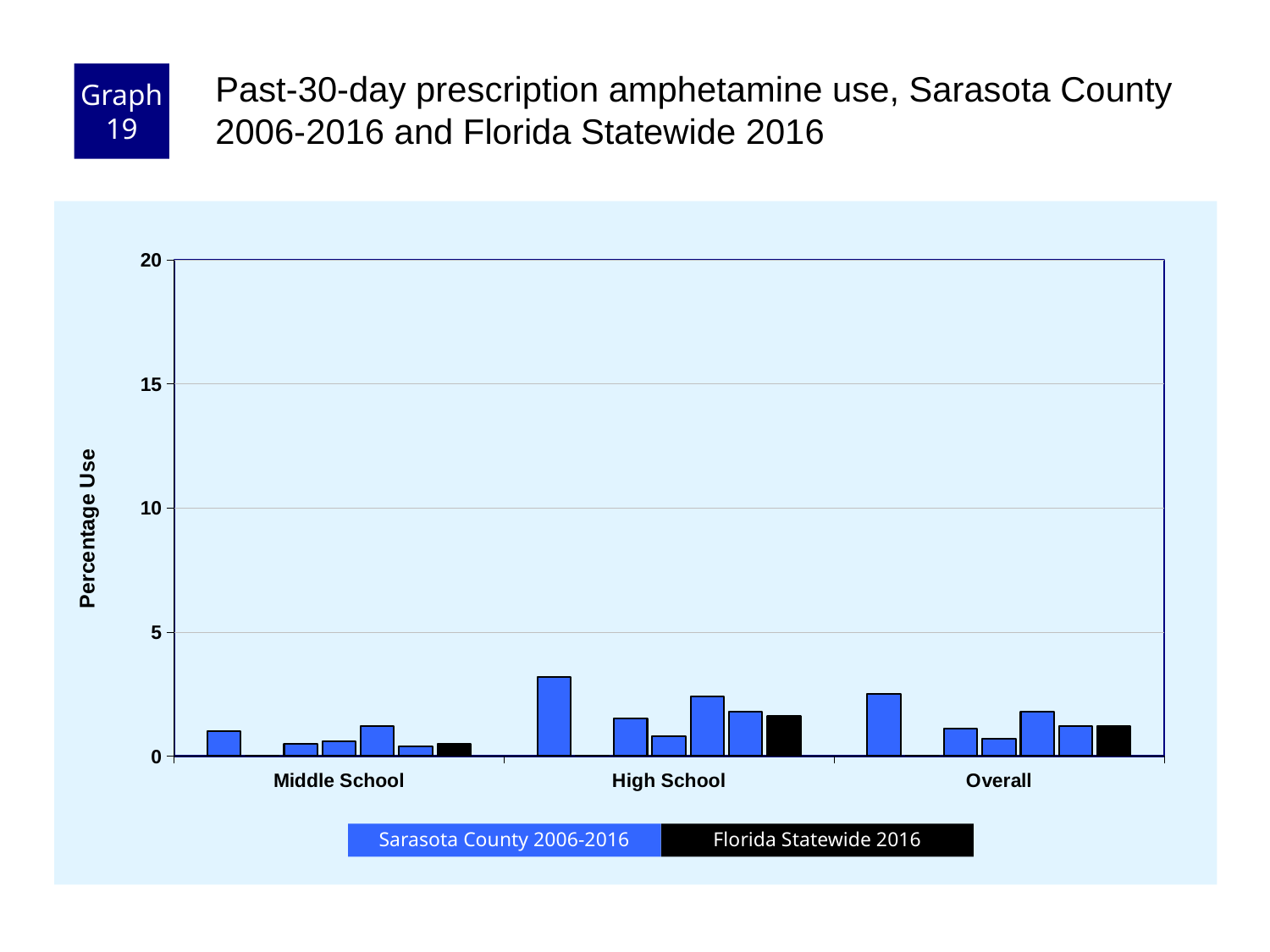
Which colour represents Florida Statewide 2016 in the legend? black How many series does the legend list? 2 Is the Florida Statewide 2016 value for Overall larger or smaller than the Florida Statewide 2016 value for Middle School? larger Is the Florida Statewide 2016 value for High School greater or less than 5? less Is the Florida Statewide 2016 value for High School larger or smaller than the Florida Statewide 2016 value for Middle School? larger Which category group has the lowest bars overall? Middle School Which category group contains the tallest bar on the chart? High School Is the tallest Sarasota County bar in the High School group greater or less than 5? less What is the label on the y axis? Percentage Use What kind of chart is shown on the slide? bar chart How many school-level categories are shown along the x axis? 3 Is the Florida Statewide 2016 value for Middle School greater or less than 5? less